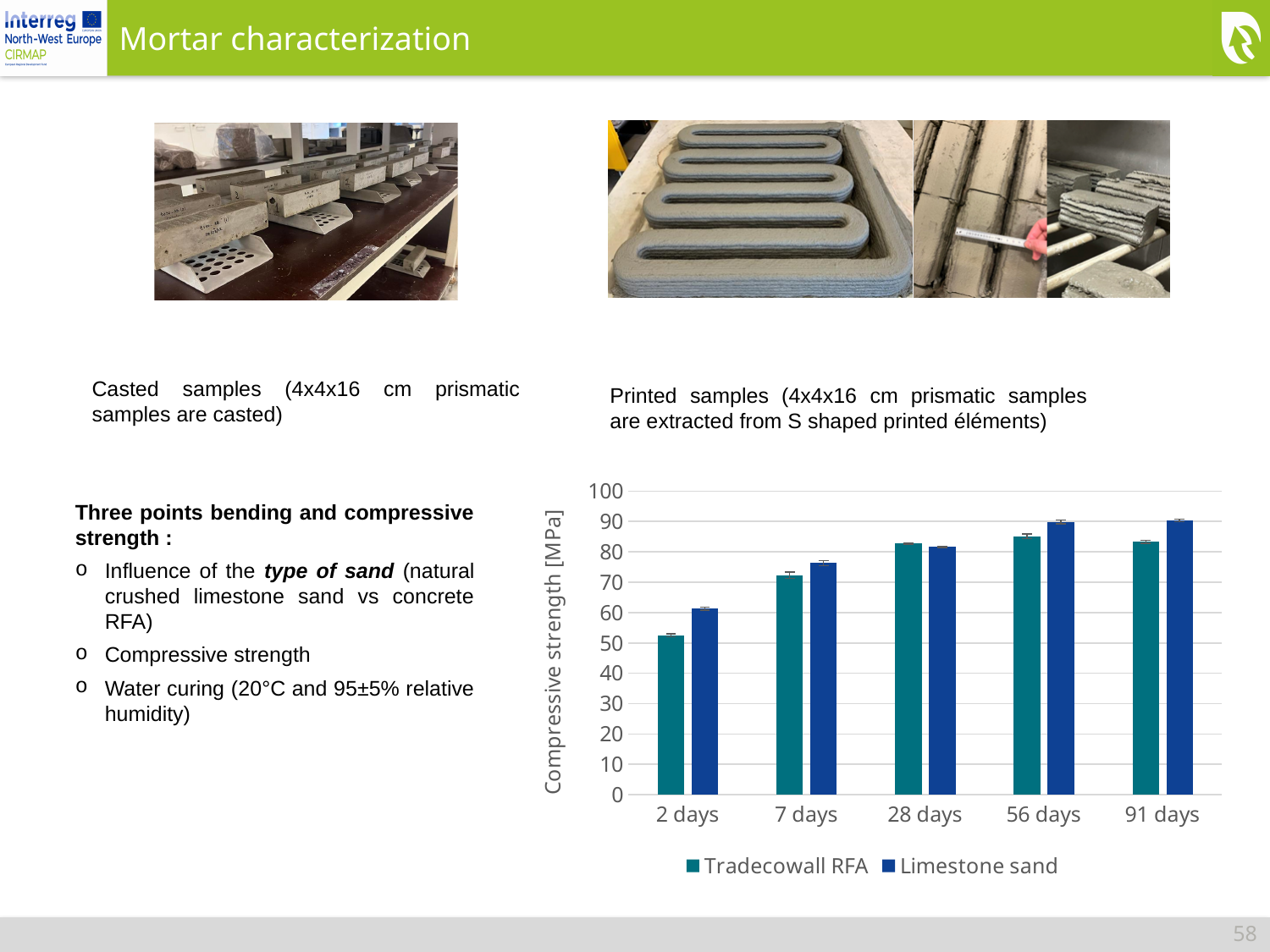
Is the compressive strength of Tradecowall RFA at 2 days greater or less than 60? less What are the two series named in the chart legend? Tradecowall RFA and Limestone sand Is the compressive strength of Limestone sand at 56 days greater or less than 80? greater At 2 days, which series has the higher compressive strength, Tradecowall RFA or Limestone sand? Limestone sand How many curing ages (categories) are shown on the x axis of the chart? 5 What kind of chart is shown on the slide? bar chart At which curing age is the compressive strength of Tradecowall RFA lowest? 2 days How many series does the chart legend list? 2 Does the compressive strength of Limestone sand rise or fall from 2 days to 91 days? rise At 91 days, which series has the higher compressive strength, Tradecowall RFA or Limestone sand? Limestone sand What is the label of the vertical axis of the chart? Compressive strength [MPa] Is the compressive strength of Tradecowall RFA at 7 days greater or less than 80? less